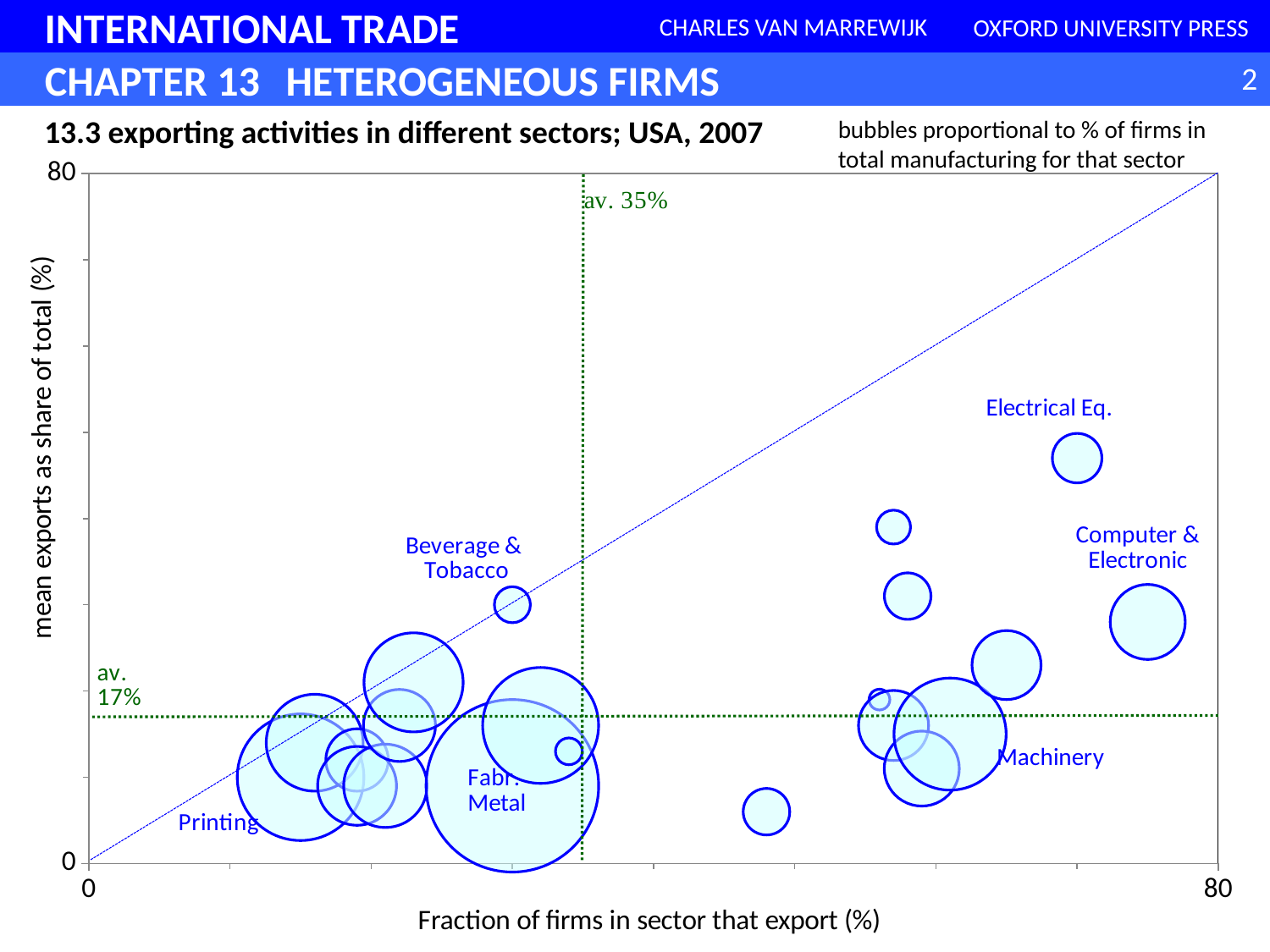
Which has a higher mean exports share: Electrical Eq. or Fabr. Metal? Electrical Eq. What average value is marked by the vertical dotted line? av. 35% Is the fraction of firms that export for Computer & Electronic greater or less than the 35% average line? greater Is the mean exports share for Electrical Eq. greater or less than the 17% average line? greater What kind of chart is shown on the slide? bubble chart What is the maximum value shown on the x axis (Fraction of firms in sector that export)? 80 What is the title of the chart? 13.3 exporting activities in different sectors; USA, 2007 What does the size of the bubbles represent, according to the note on the chart? % of firms in total manufacturing for that sector Which labeled sector has the highest mean exports as share of total? Electrical Eq. Is the fraction of firms that export for Printing greater or less than the 35% average line? less Which labeled sector has the highest fraction of firms that export? Computer & Electronic What average value is marked by the horizontal dotted line? av. 17%